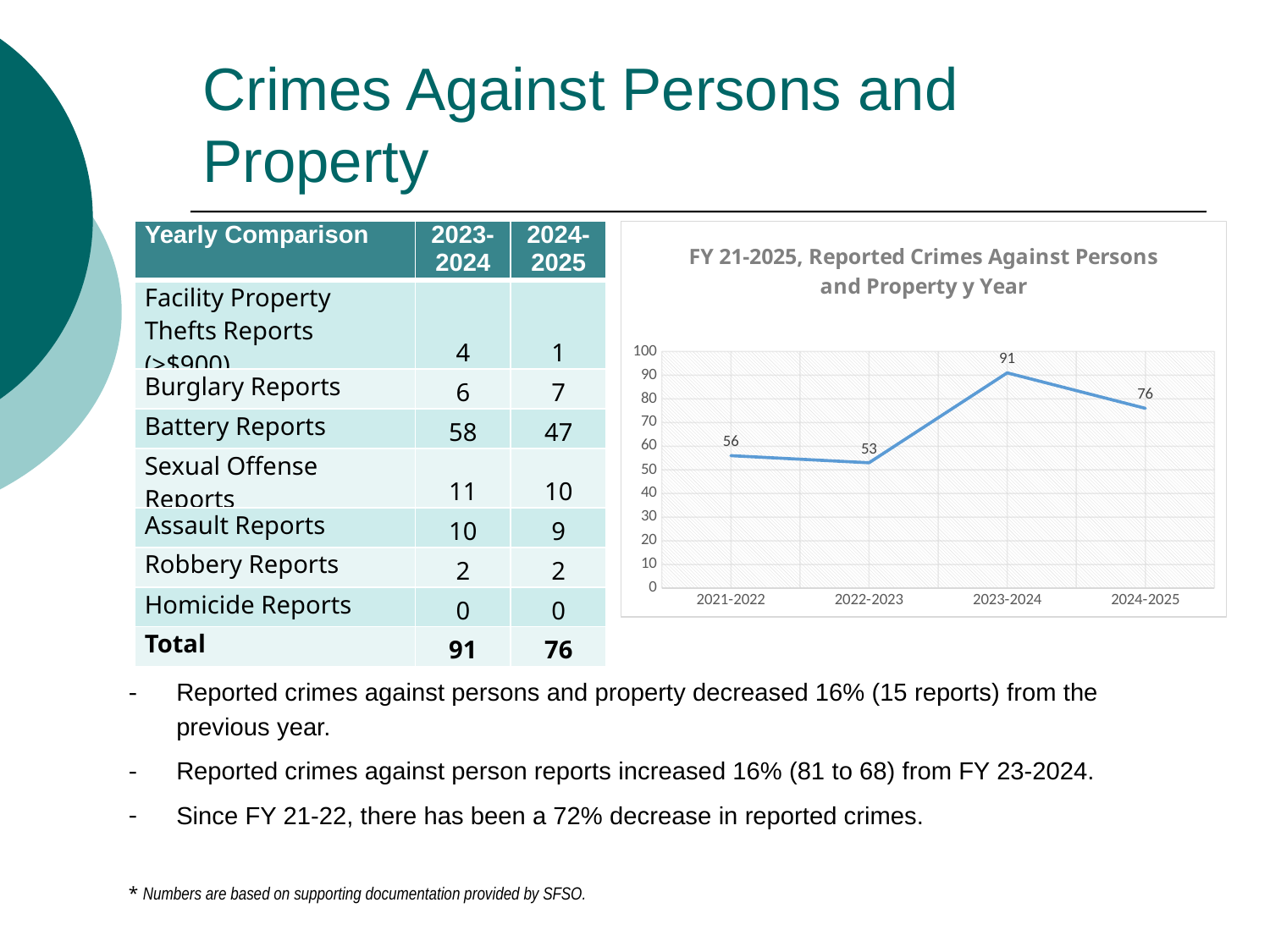
Which fiscal year has the highest value in the chart? 2023-2024 Which is larger, the value for 2021-2022 or the value for 2022-2023? 2021-2022 What is the value for 2023-2024 in the chart? 91 What is the difference between the values for 2023-2024 and 2024-2025? 15 What is the value for 2024-2025 in the chart? 76 Is the value for 2024-2025 greater or less than 70? greater Which fiscal year has the lowest value in the chart? 2022-2023 Does the value rise or fall from 2022-2023 to 2023-2024? rise What is the value for 2022-2023 in the chart? 53 What is the value for 2021-2022 in the chart? 56 What type of chart is shown on the slide? line chart How many fiscal years are plotted in the chart? 4